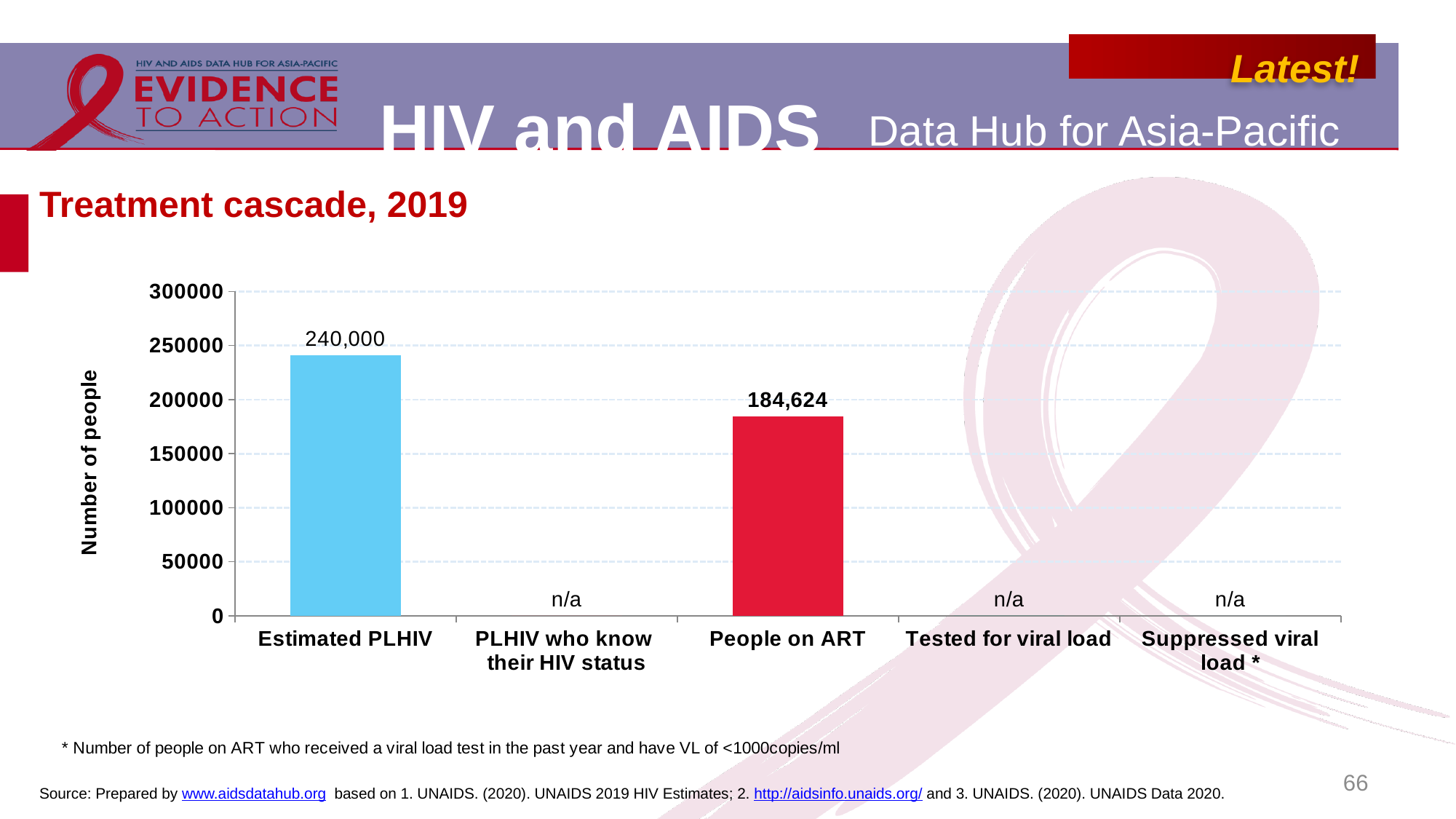
Which category has the highest plotted value? Estimated PLHIV What is the y-axis label of the chart? Number of people How many categories are shown on the x axis? 5 How many categories are marked n/a? 3 Which is larger, Estimated PLHIV or People on ART? Estimated PLHIV What is the value for Estimated PLHIV? 240,000 What is shown for PLHIV who know their HIV status? n/a What is the value for People on ART? 184,624 Is the value for People on ART greater or less than 200000? less What is the difference between Estimated PLHIV and People on ART? 55,376 What kind of chart is this? bar chart What is shown for Suppressed viral load? n/a